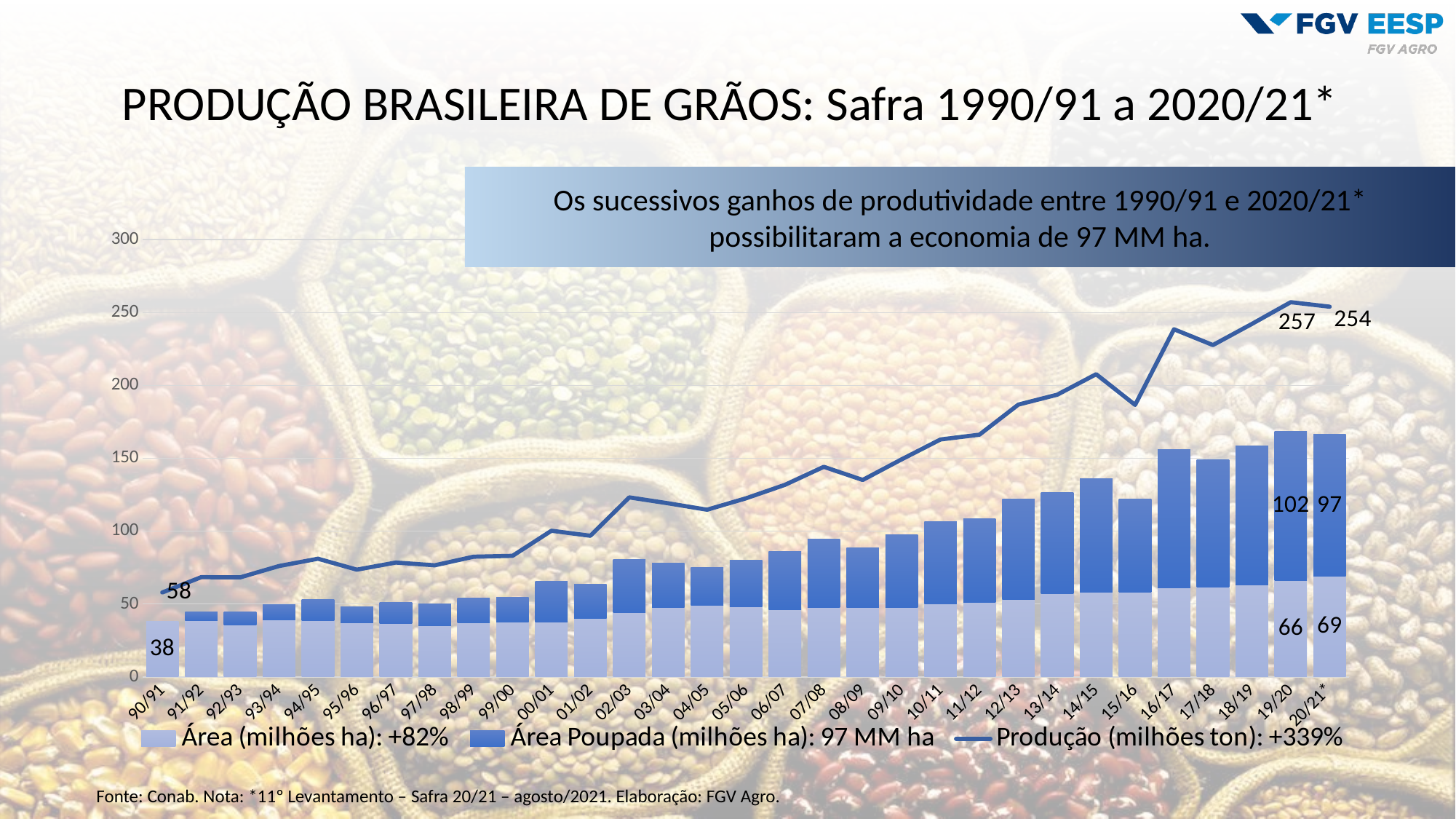
How many harvest seasons (categories) are shown on the x axis? 31 How many series does the legend list? 3 What is the difference between Produção in 19/20 and Produção in 90/91? 199 What is the value of Área (milhões ha) for 20/21*? 69 What is the value of Produção (milhões ton) for 19/20? 257 Is the Produção value for 15/16 greater or less than 200? less What is the value of Área Poupada (milhões ha) for 19/20? 102 What is the value of Produção (milhões ton) for 20/21*? 254 What is the total height of the stacked bar for 20/21* (Área plus Área Poupada)? 166 What is the value of Área (milhões ha) for 90/91? 38 Which is larger: Área Poupada in 19/20 or Área Poupada in 20/21*? 19/20 Does the Produção line generally rise or fall from 90/91 to 20/21*? rise